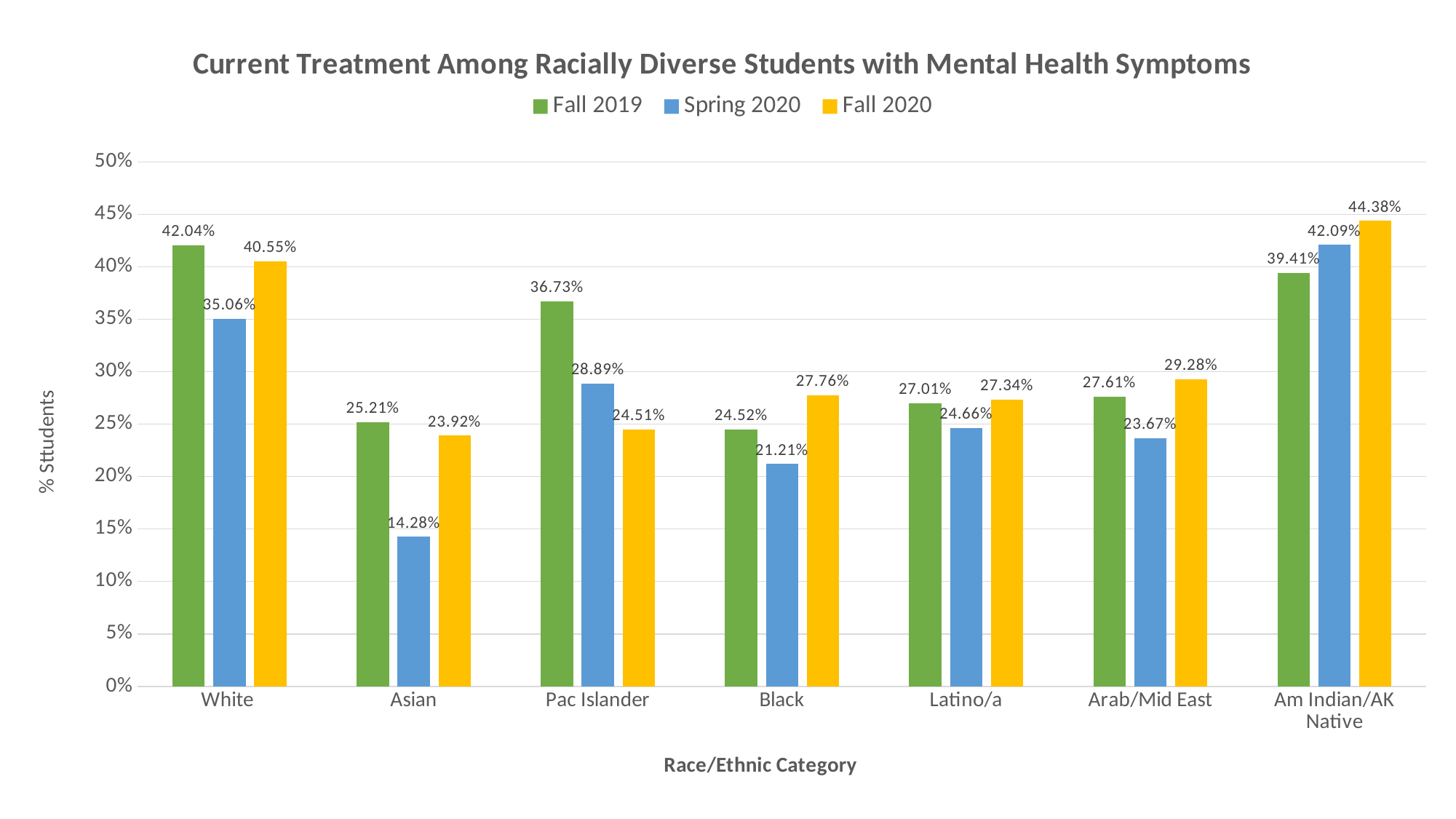
Which race/ethnic category has the lowest Spring 2020 value? Asian What is the label of the y axis? % Sttudents What is the Fall 2020 value for Arab/Mid East students? 29.28% What kind of chart is shown on the slide? Bar chart Which race/ethnic category has the highest Fall 2020 value? Am Indian/AK Native How many series does the legend list? 3 What is the difference between the Fall 2020 and Fall 2019 values for Am Indian/AK Native students? 4.97% How many race/ethnic categories are shown on the x axis? 7 Which is larger for Pac Islander students: the Fall 2019 value or the Fall 2020 value? Fall 2019 What is the difference between the Fall 2019 and Spring 2020 values for White students? 6.98% What is the Fall 2019 value for White students? 42.04% What is the Spring 2020 value for Asian students? 14.28%